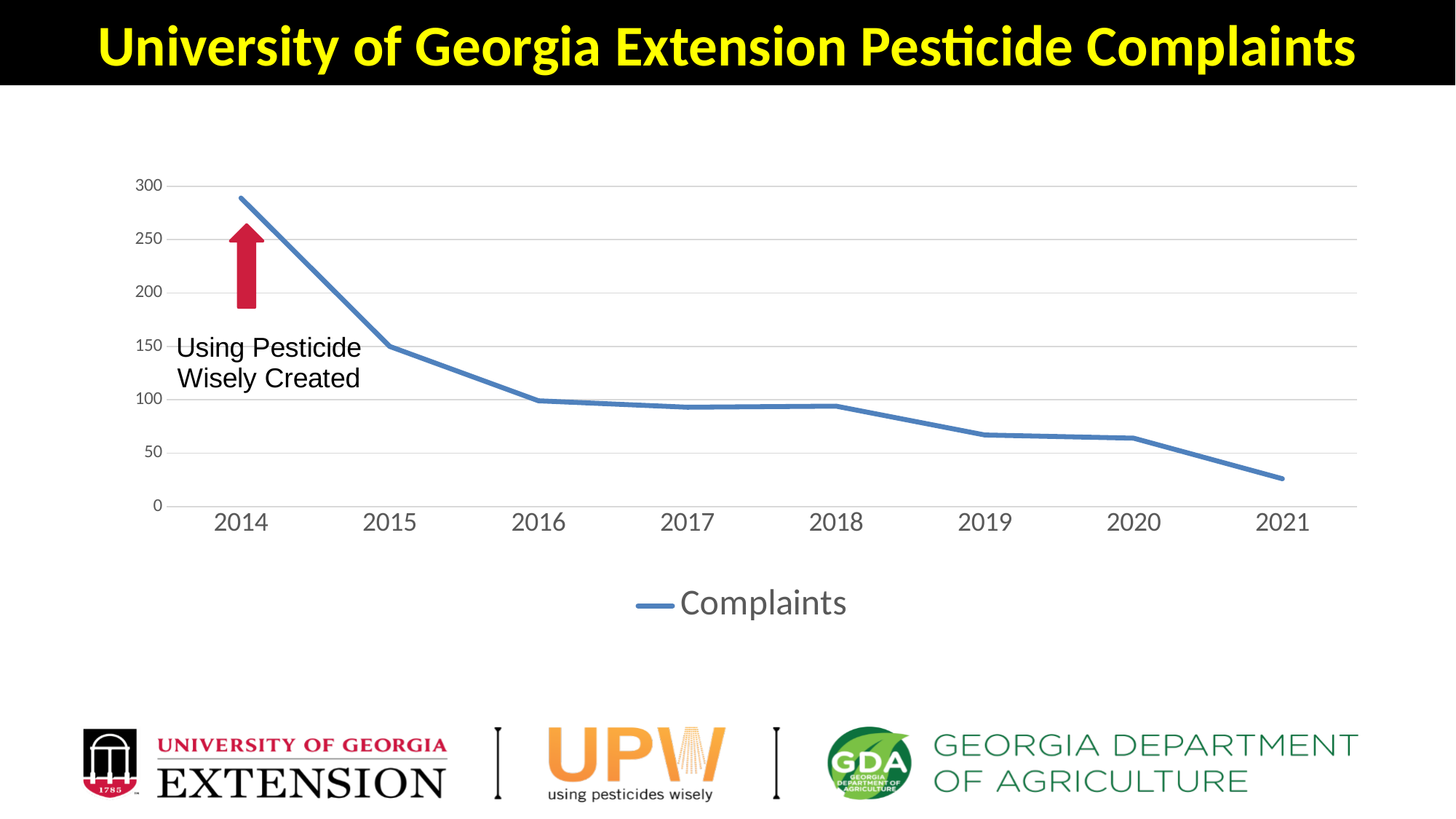
Is the value for 2021 greater or less than 50? less Which year has more complaints, 2015 or 2018? 2015 Which year has the lowest number of complaints? 2021 Which year has the highest number of complaints? 2014 What is the name of the series shown in the legend? Complaints Is the value for 2014 greater or less than 250? greater How many series does the legend list? 1 What kind of chart is shown on the slide? line chart What does the annotation with the red arrow next to the 2014 point say? Using Pesticide Wisely Created Is the value for 2019 greater or less than 100? less How many years are plotted on the x axis? 8 Do the complaints rise or fall from 2014 to 2021? fall